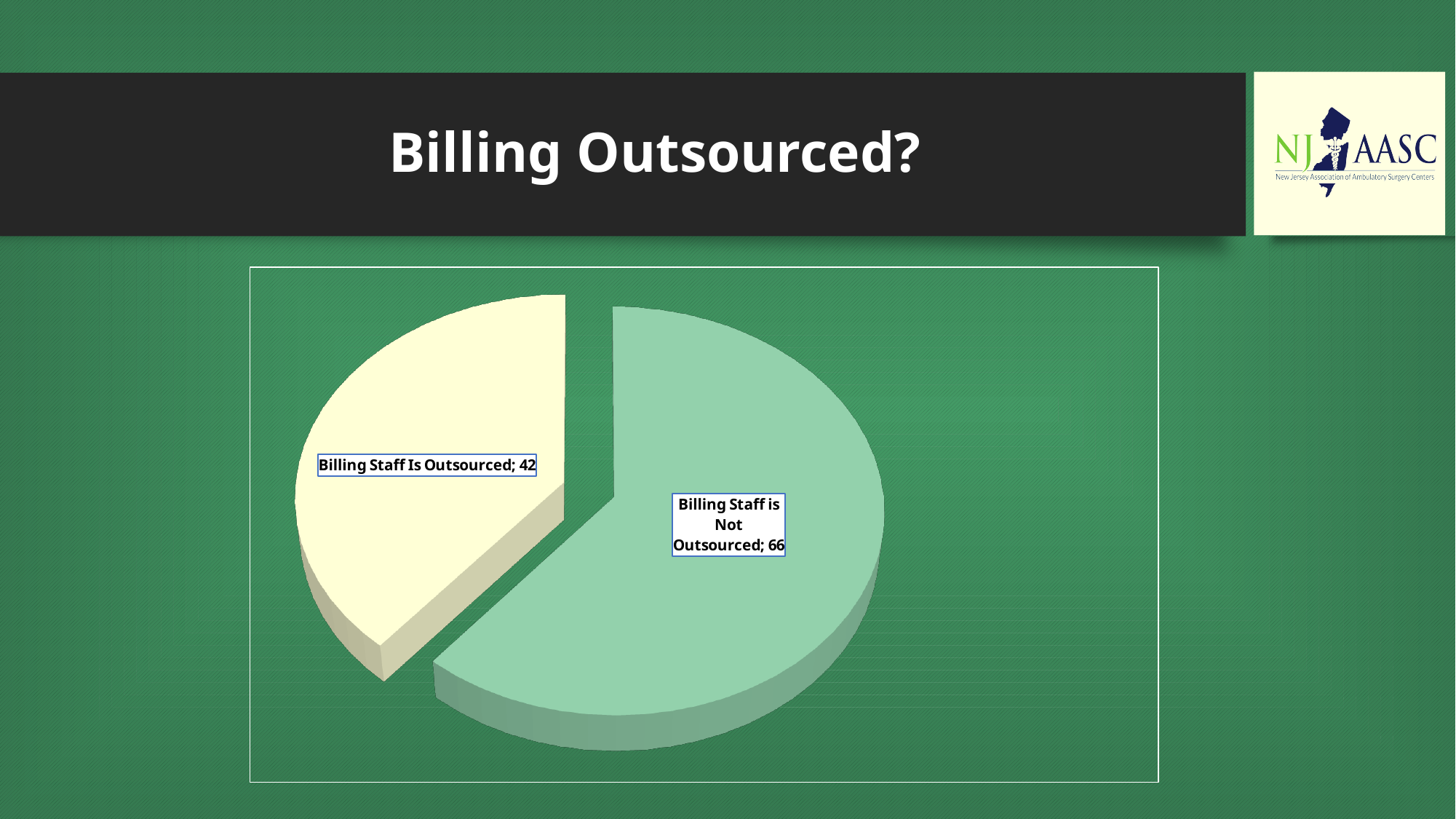
Which slice of the pie chart is the largest? Billing Staff is Not Outsourced What is the difference between the 'Billing Staff is Not Outsourced' value and the 'Billing Staff Is Outsourced' value? 24 What share of the pie does the 'Billing Staff is Not Outsourced' slice represent? 61.1% What is the value for the 'Billing Staff is Not Outsourced' slice? 66 What kind of chart is shown on the slide? Pie chart Which slice of the pie chart is the smallest? Billing Staff Is Outsourced What is the total of the two slice values in the pie chart? 108 What is the value for the 'Billing Staff Is Outsourced' slice? 42 What is the title of the slide containing the pie chart? Billing Outsourced? How many slices does the pie chart have? 2 What colour is the 'Billing Staff Is Outsourced' slice? Pale yellow Which is larger: 'Billing Staff Is Outsourced' or 'Billing Staff is Not Outsourced'? Billing Staff is Not Outsourced